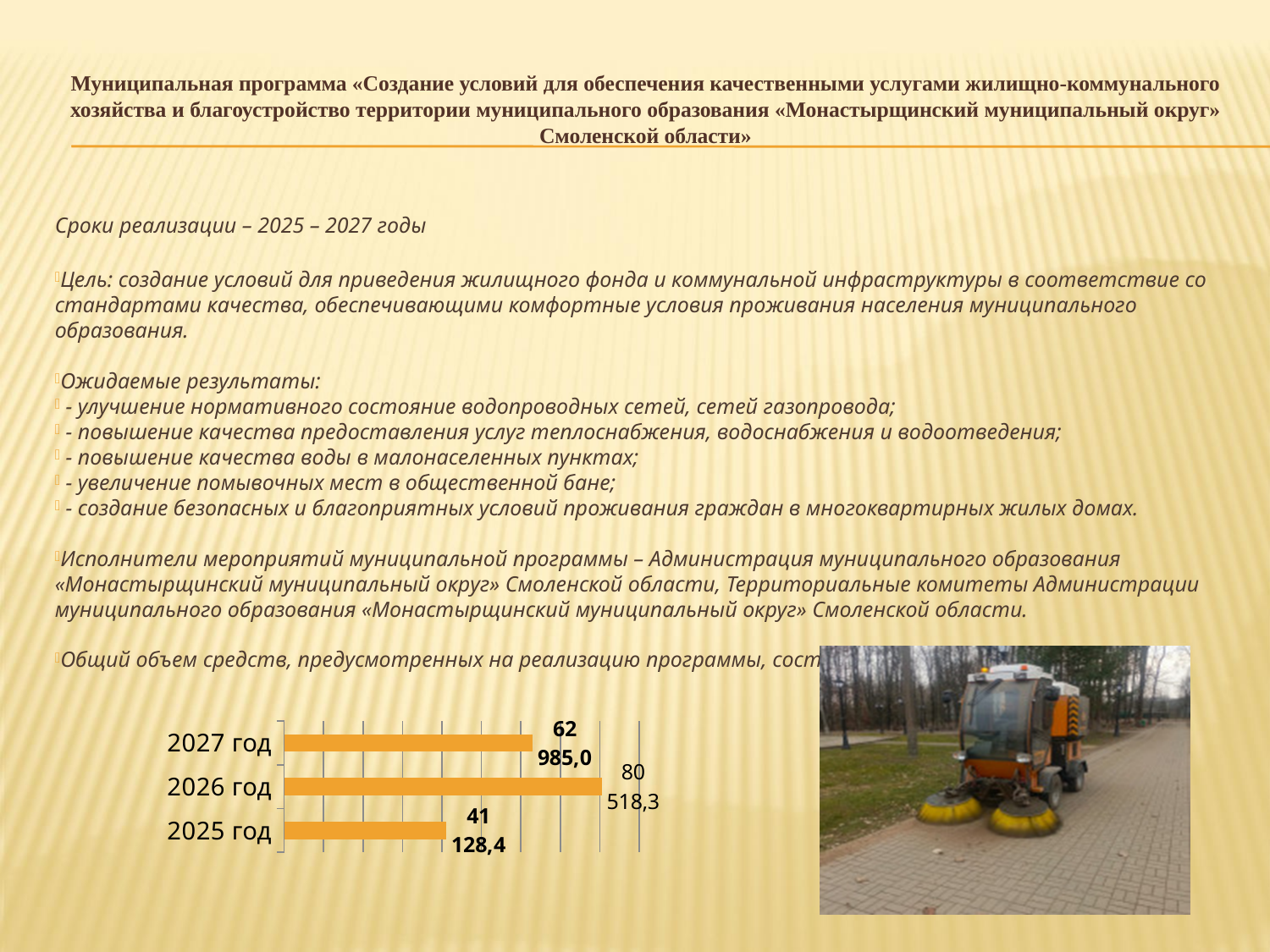
What type of chart is shown on the slide? bar chart Do the values rise or fall from 2026 год to 2027 год? fall How many categories (years) does the chart show? 3 Which is larger, the value for 2027 год or the value for 2025 год? 2027 год What is the value shown for 2027 год? 62 985,0 What is the difference between the values for 2026 год and 2025 год? 39 389,9 Which year has the highest value in the chart? 2026 год What is the difference between the values for 2026 год and 2027 год? 17 533,3 What colour are the bars in the chart? orange Which year has the lowest value in the chart? 2025 год What is the value shown for 2025 год? 41 128,4 What is the value shown for 2026 год? 80 518,3